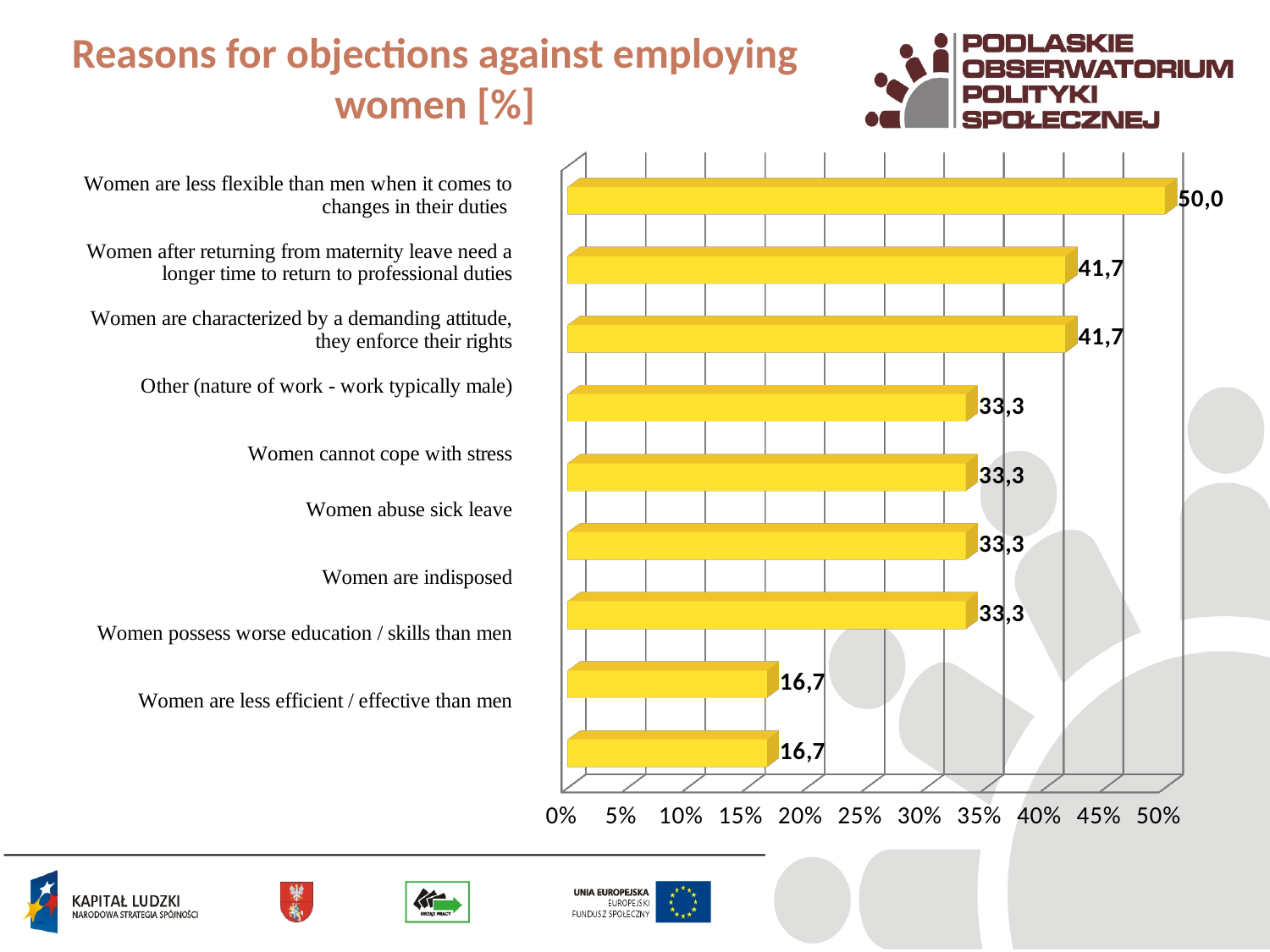
What is the value for "Women are less flexible than men when it comes to changes in their duties"? 50,0 What is the difference between the value for "Women are less flexible than men when it comes to changes in their duties" and the value for "Women are less efficient / effective than men"? 33,3 What kind of chart is shown on the slide? bar chart What is the value for "Women possess worse education / skills than men"? 16,7 What is the difference between the value for "Women are characterized by a demanding attitude, they enforce their rights" and the value for "Women abuse sick leave"? 8,4 How many reasons (categories) are plotted in the chart? 9 What is the value for "Women after returning from maternity leave need a longer time to return to professional duties"? 41,7 What is the title of the chart on the slide? Reasons for objections against employing women [%] Which reason has the highest value? Women are less flexible than men when it comes to changes in their duties What is the value for "Women are less efficient / effective than men"? 16,7 What is the value for "Women cannot cope with stress"? 33,3 Which is larger: the value for "Women are indisposed" or the value for "Women possess worse education / skills than men"? Women are indisposed